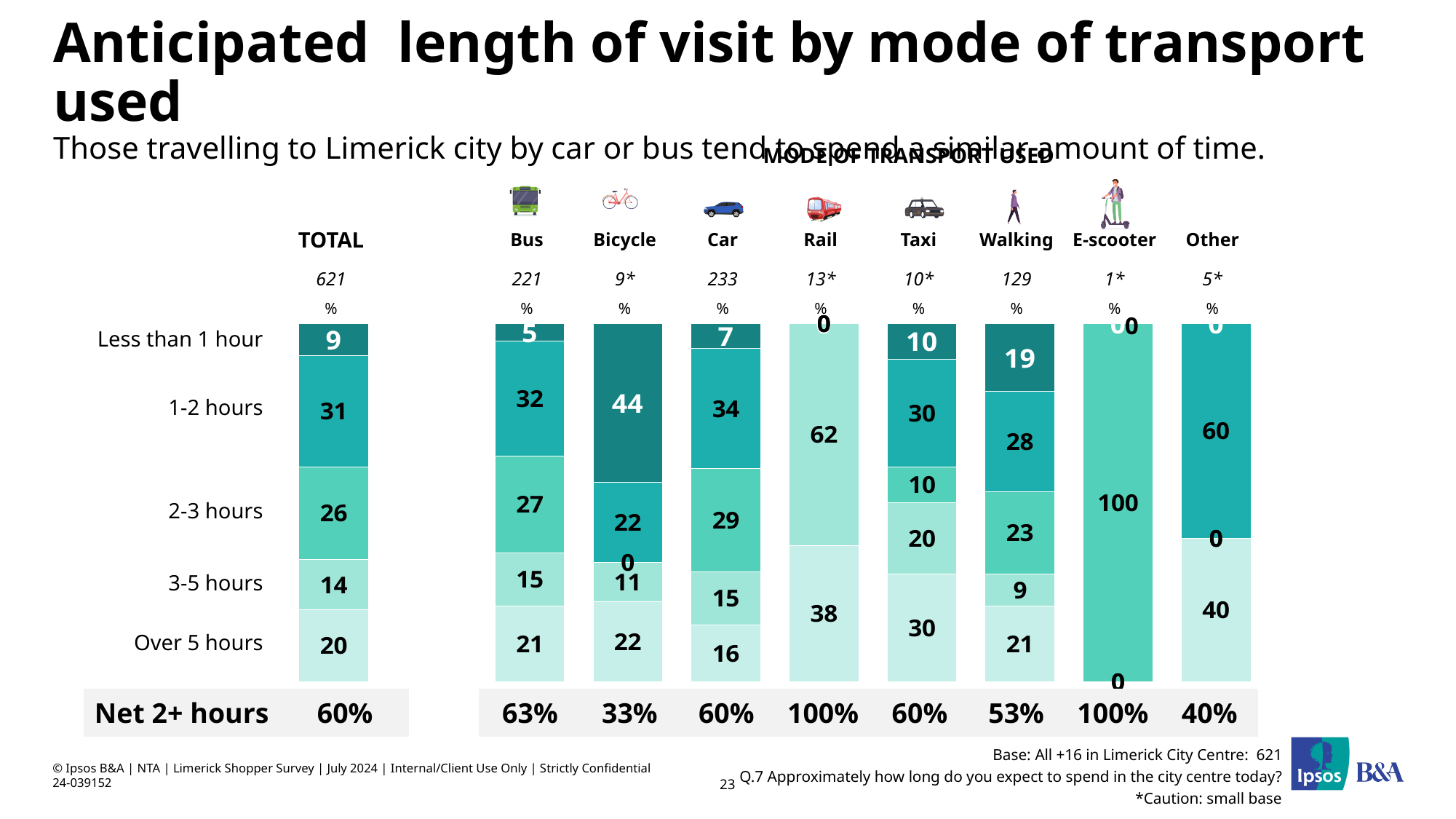
What kind of chart is shown on the slide? Stacked bar chart What percentage of those travelling by car anticipate a visit of 1-2 hours? 34 What is the Net 2+ hours value for Bus? 63% In the TOTAL bar, which length-of-visit category has the highest value? 1-2 hours In the TOTAL bar, what is the value for 2-3 hours? 26 Which is larger, the Over 5 hours value for Taxi or for Walking? Taxi What percentage of those walking anticipate a visit of less than 1 hour? 19 Which mode of transport has the lowest Net 2+ hours value? Bicycle What is the difference between the 1-2 hours values for Car and Bus? 2 What is the Net 2+ hours value for Walking? 53% What is the base (number of respondents) for Car? 233 How many modes of transport are shown, excluding the TOTAL bar? 8